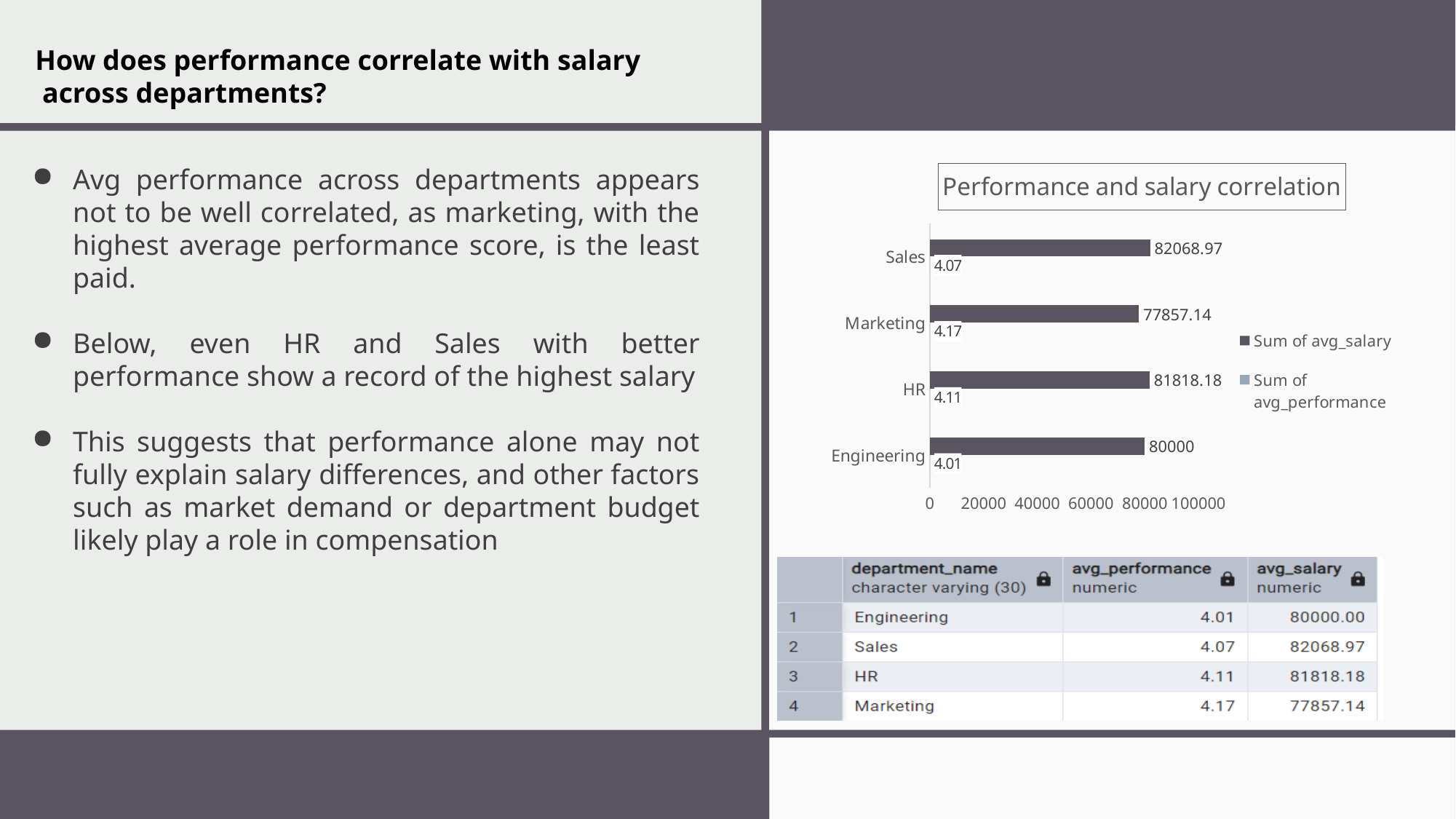
What is the difference in Sum of avg_salary between Sales and Marketing? 4211.83 What is the Sum of avg_salary value for Sales? 82068.97 Which department has the lowest Sum of avg_salary? Marketing What is the Sum of avg_salary value for Engineering? 80000 Which department has the highest Sum of avg_performance? Marketing How many series does the legend list? 2 What is the Sum of avg_performance value for Marketing? 4.17 Which has a larger Sum of avg_salary, HR or Engineering? HR What kind of chart is shown on the slide? Bar chart What is the title of the chart? Performance and salary correlation Which department has the highest Sum of avg_salary? Sales How many departments are shown on the chart? 4